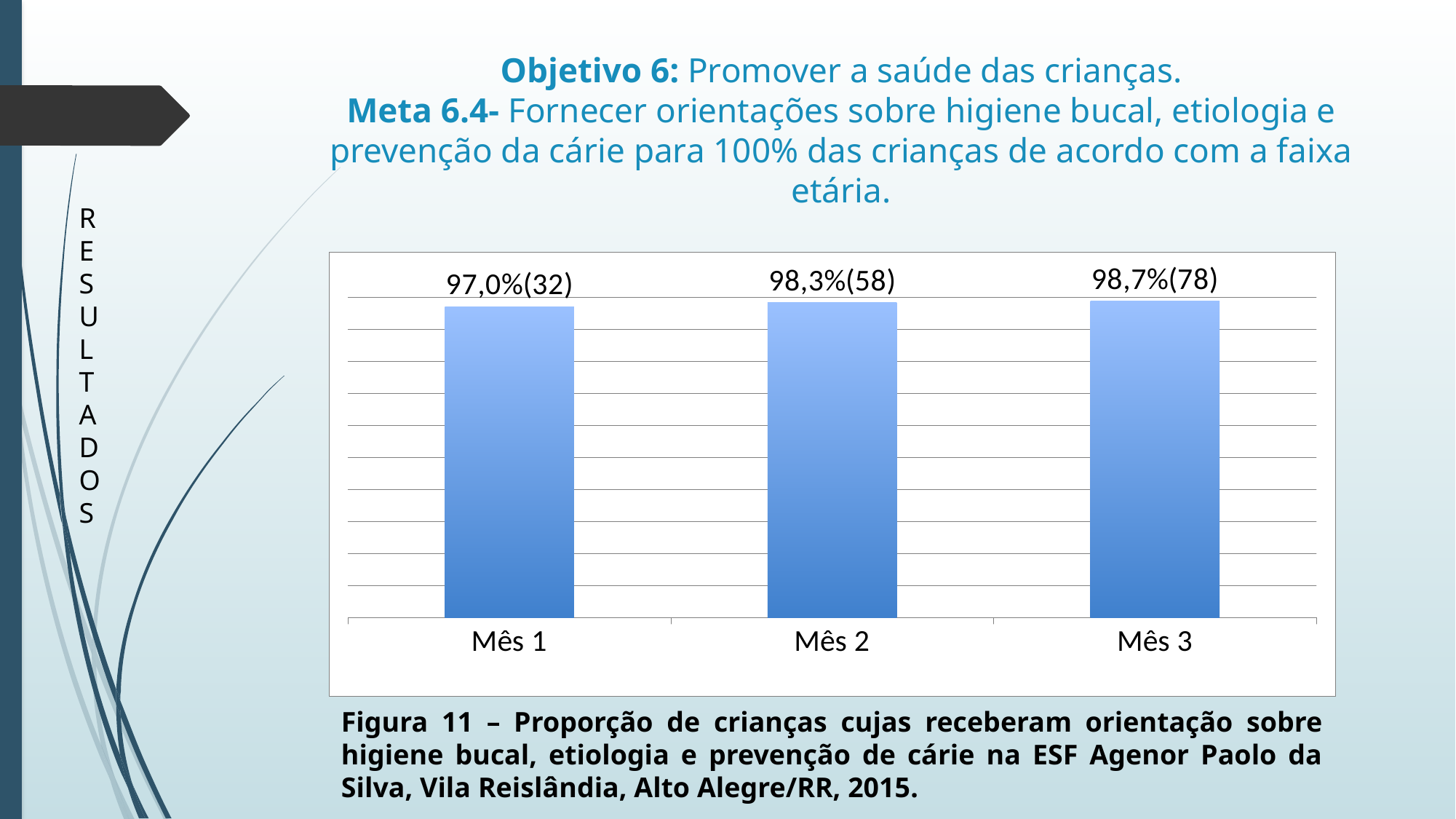
What is the difference in the number of children (in parentheses) between Mês 3 and Mês 1? 46 What percentage is shown for Mês 2? 98,3% What is the value shown for Mês 3? 98,7%(78) How many months (categories) are shown on the x axis? 3 Which has a higher percentage, Mês 1 or Mês 2? Mês 2 How many children are shown in parentheses for Mês 3? 78 What is the value shown for Mês 1? 97,0%(32) Do the percentages rise or fall from Mês 1 to Mês 3? Rise What type of chart is shown on the slide? Bar chart Which month has the lowest percentage? Mês 1 What is the value shown for Mês 2? 98,3%(58) Which month has the highest percentage? Mês 3